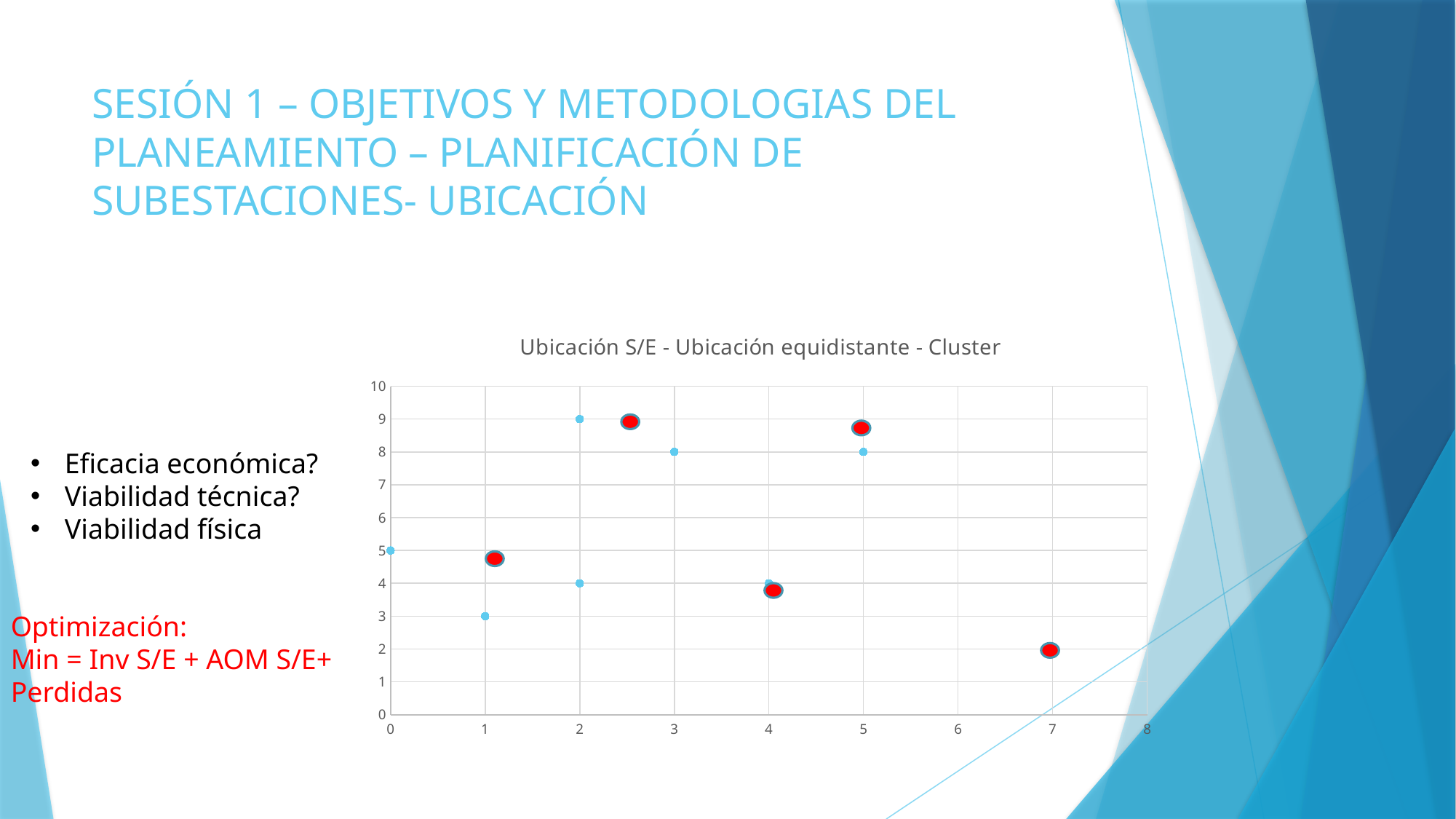
What is the title of the chart? Ubicación S/E - Ubicación equidistante - Cluster What is the y value of the small blue point plotted at x = 3? 8 Which of the two small blue points at x = 2 has the larger y value, the upper one at 9 or the lower one at 4? the one at 9 What is the highest value shown on the vertical axis of the chart? 10 What kind of chart is shown on the slide? scatter chart Is the y value of the red marker near x = 2.5 greater or less than 8? greater Is the y value of the red marker near x = 7 greater or less than 3? less What is the y value of the small blue point plotted at x = 0? 5 Is the y value of the red marker near x = 1 greater or less than 4? greater Which red marker has the lowest y value: the one near x = 7 or the one near x = 4? the one near x = 7 What is the y value of the small blue point plotted at x = 1? 3 How many large red markers are plotted on the chart? 5